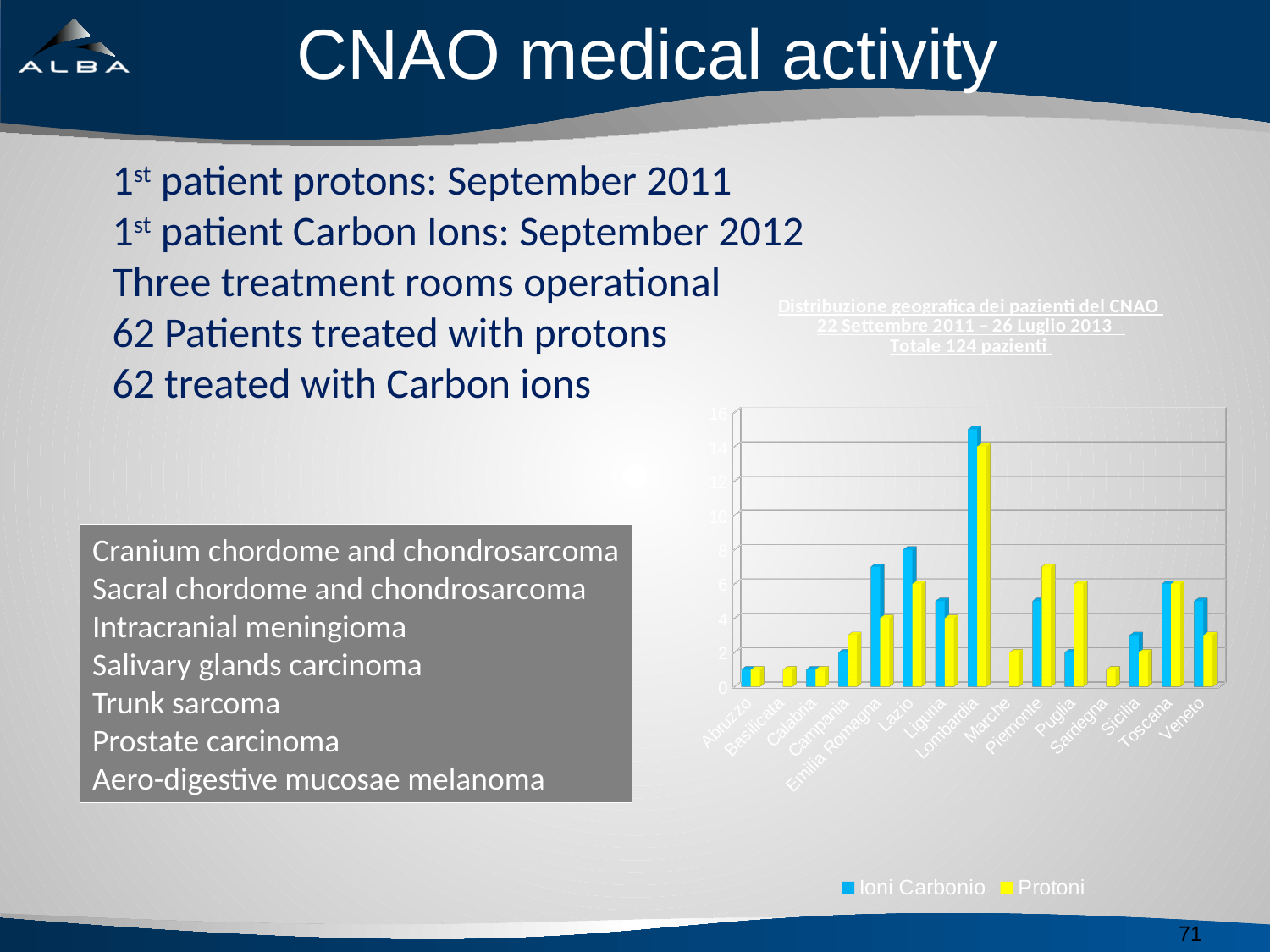
How many series does the chart legend list? 2 What kind of chart is shown on the slide? Bar chart How many regions (categories) are shown on the x axis of the chart? 15 Is the Ioni Carbonio value for Lombardia greater or less than 10? greater What are the two series named in the chart legend? Ioni Carbonio and Protoni For Emilia Romagna, which series has the larger value, Ioni Carbonio or Protoni? Ioni Carbonio Is the Protoni value for Lombardia greater or less than 10? greater For Piemonte, which series has the larger value, Ioni Carbonio or Protoni? Protoni Which region has the highest value for Protoni? Lombardia Which region has the highest value for Ioni Carbonio? Lombardia Is the Ioni Carbonio value for Lazio greater or less than 4? greater